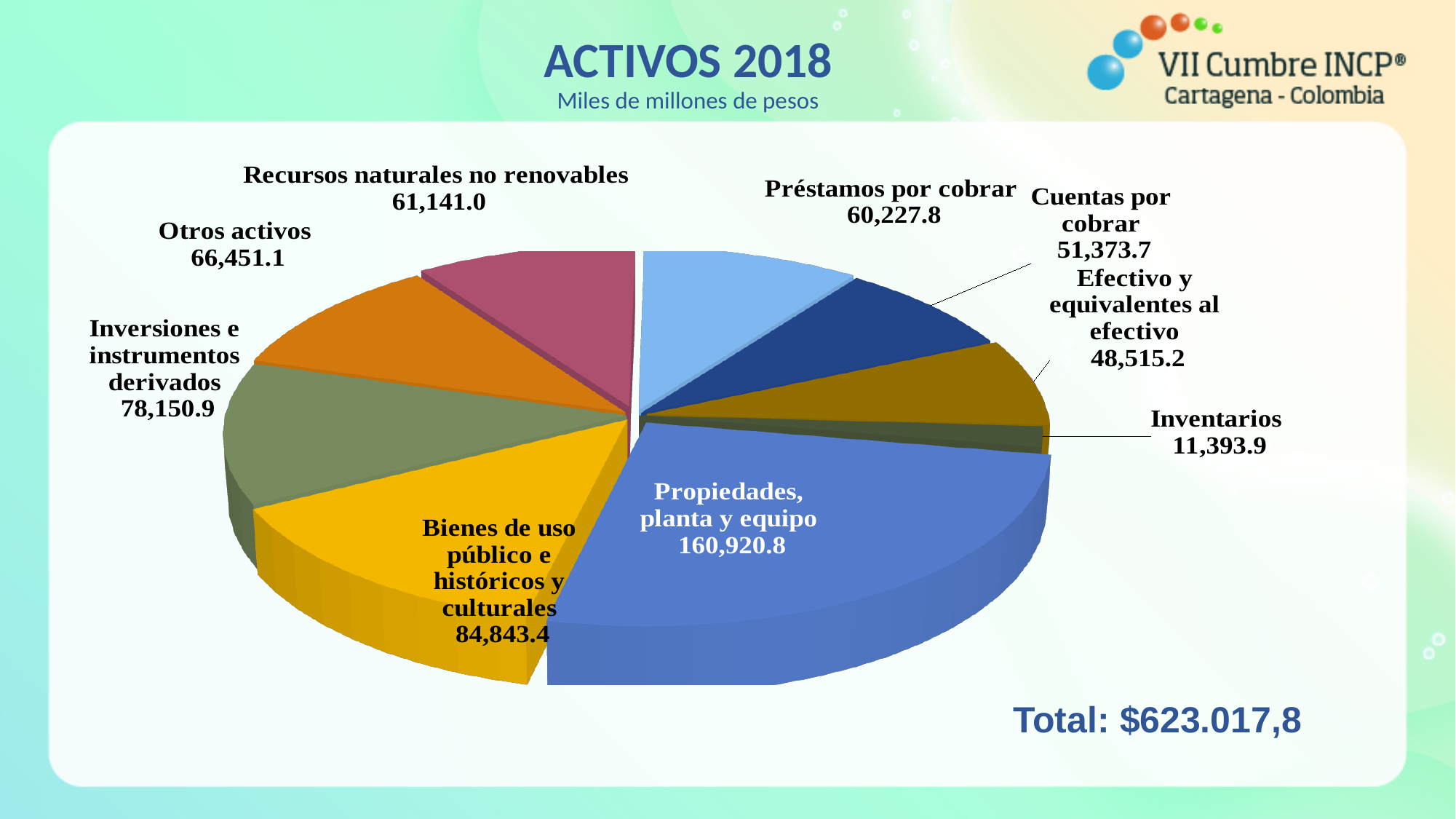
What is the difference between Propiedades, planta y equipo and Bienes de uso público e históricos y culturales? 76,077.4 What type of chart is shown on the slide? Pie chart What is the value for Inventarios? 11,393.9 Which is larger, Otros activos or Recursos naturales no renovables? Otros activos What unit is stated under the chart title? Miles de millones de pesos How many categories are shown in the pie chart? 9 Which category has the largest value? Propiedades, planta y equipo Which category has the smallest value? Inventarios What total is printed on the slide? $623.017,8 What is the value for Efectivo y equivalentes al efectivo? 48,515.2 What is the value for Inversiones e instrumentos derivados? 78,150.9 What is the value for Propiedades, planta y equipo? 160,920.8